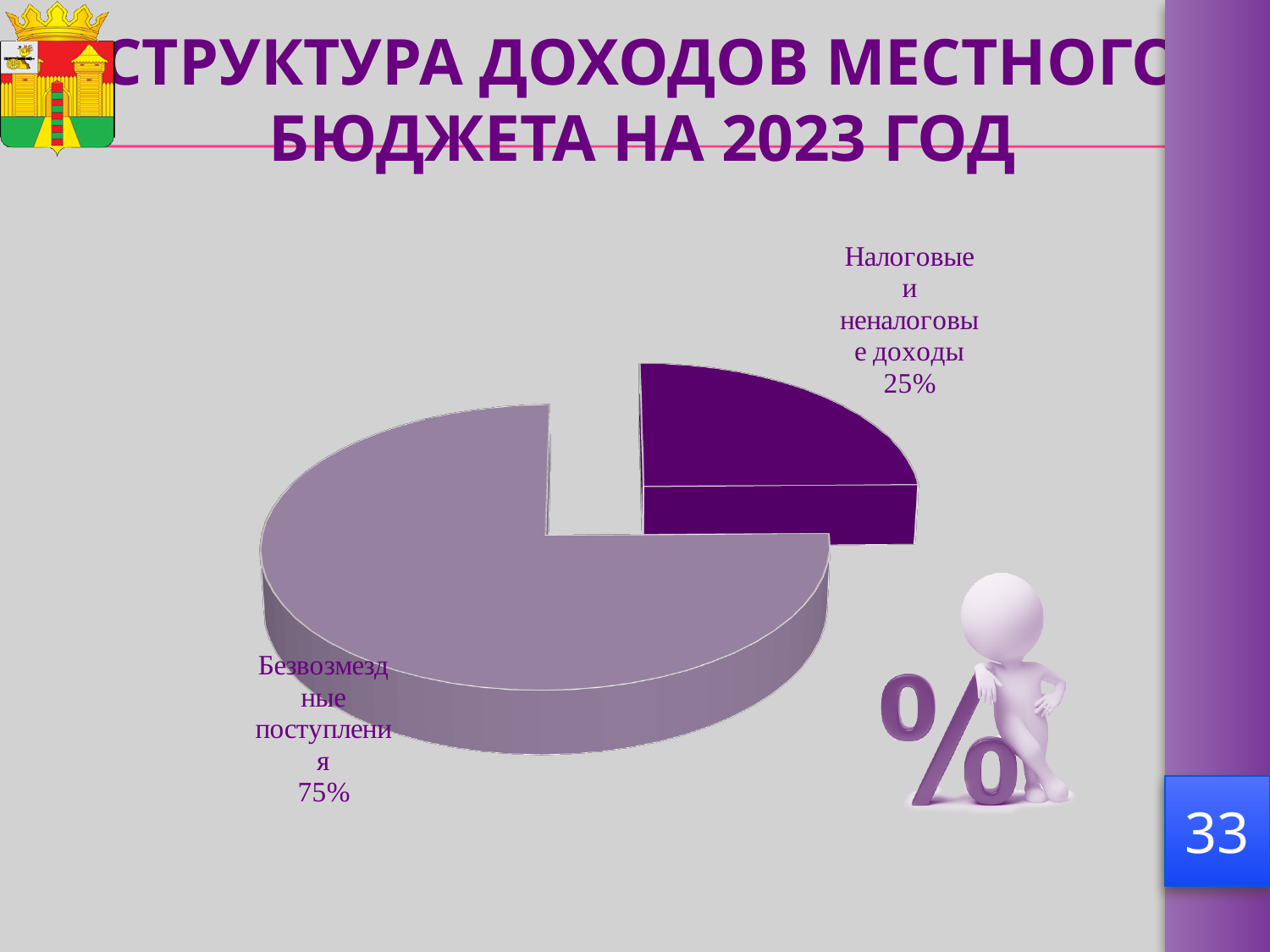
What share of the pie does "Налоговые и неналоговые доходы" have? 25% How many slices does the pie chart have? 2 What share of the pie does "Безвозмездные поступления" have? 75% Which slice of the pie is the smallest? Налоговые и неналоговые доходы Which is larger: the share for "Налоговые и неналоговые доходы" or the share for "Безвозмездные поступления"? Безвозмездные поступления What is the title of the slide containing the chart? СТРУКТУРА ДОХОДОВ МЕСТНОГО БЮДЖЕТА НА 2023 ГОД Which slice of the pie is the largest? Безвозмездные поступления What is the difference in percentage points between "Безвозмездные поступления" and "Налоговые и неналоговые доходы"? 50 Which slice is shown in dark purple? Налоговые и неналоговые доходы What kind of chart is shown on the slide? pie chart